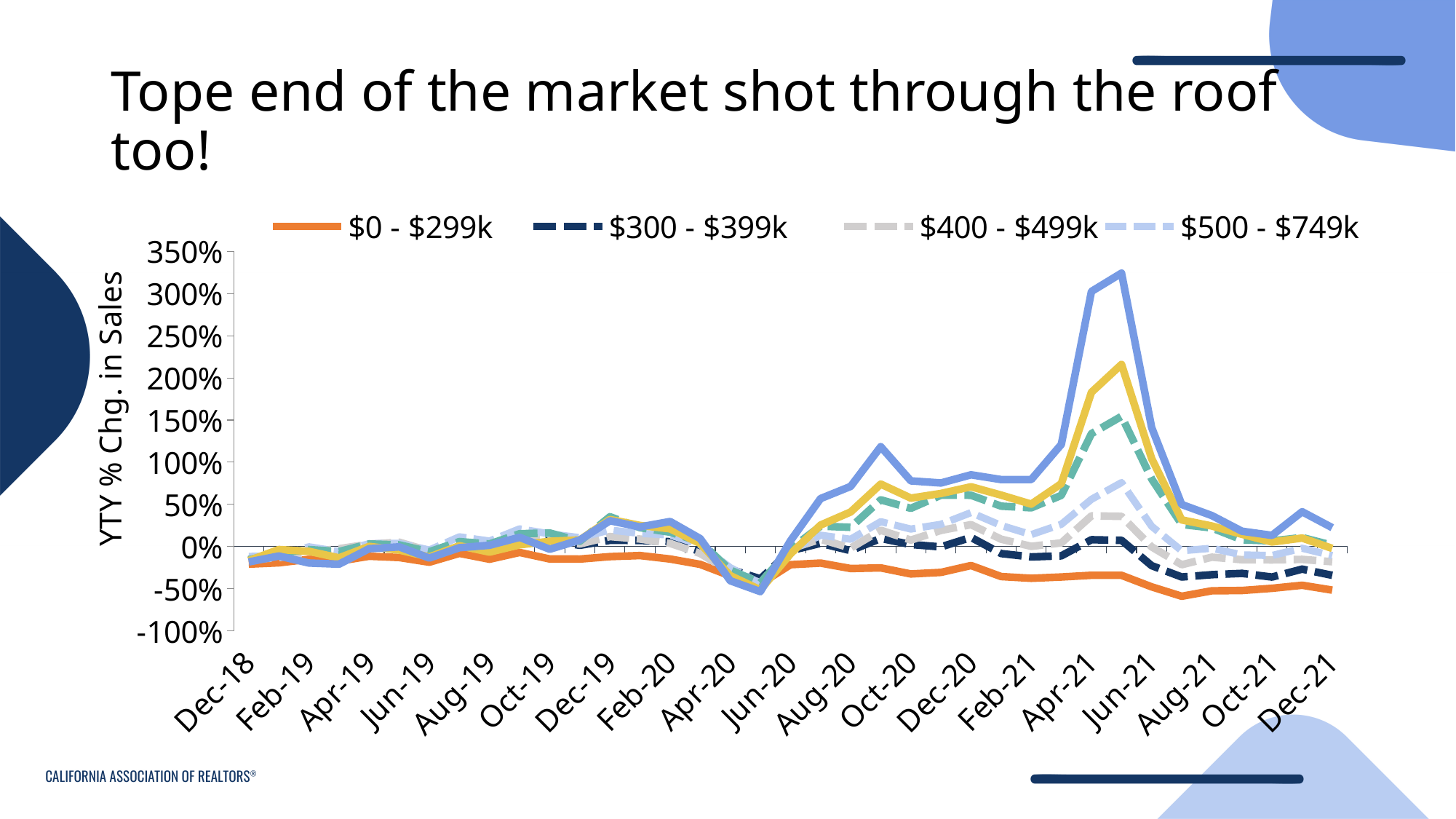
Is the value for $500 - $749k in Oct-20 greater or less than 100%? less What is the title of the slide? Tope end of the market shot through the roof too! Does the $0 - $299k line rise or fall from Apr-21 to Aug-21? fall Is the value for $400 - $499k in Dec-21 greater or less than 0%? less How many month labels are shown on the x axis? 19 Which legend entry is drawn as a solid orange line? $0 - $299k Does the $500 - $749k line rise or fall from Jun-20 to Oct-20? rise What kind of chart is shown on the slide? line chart How many series does the legend list? 4 Is the value for $0 - $299k in Jun-20 greater or less than -50%? greater